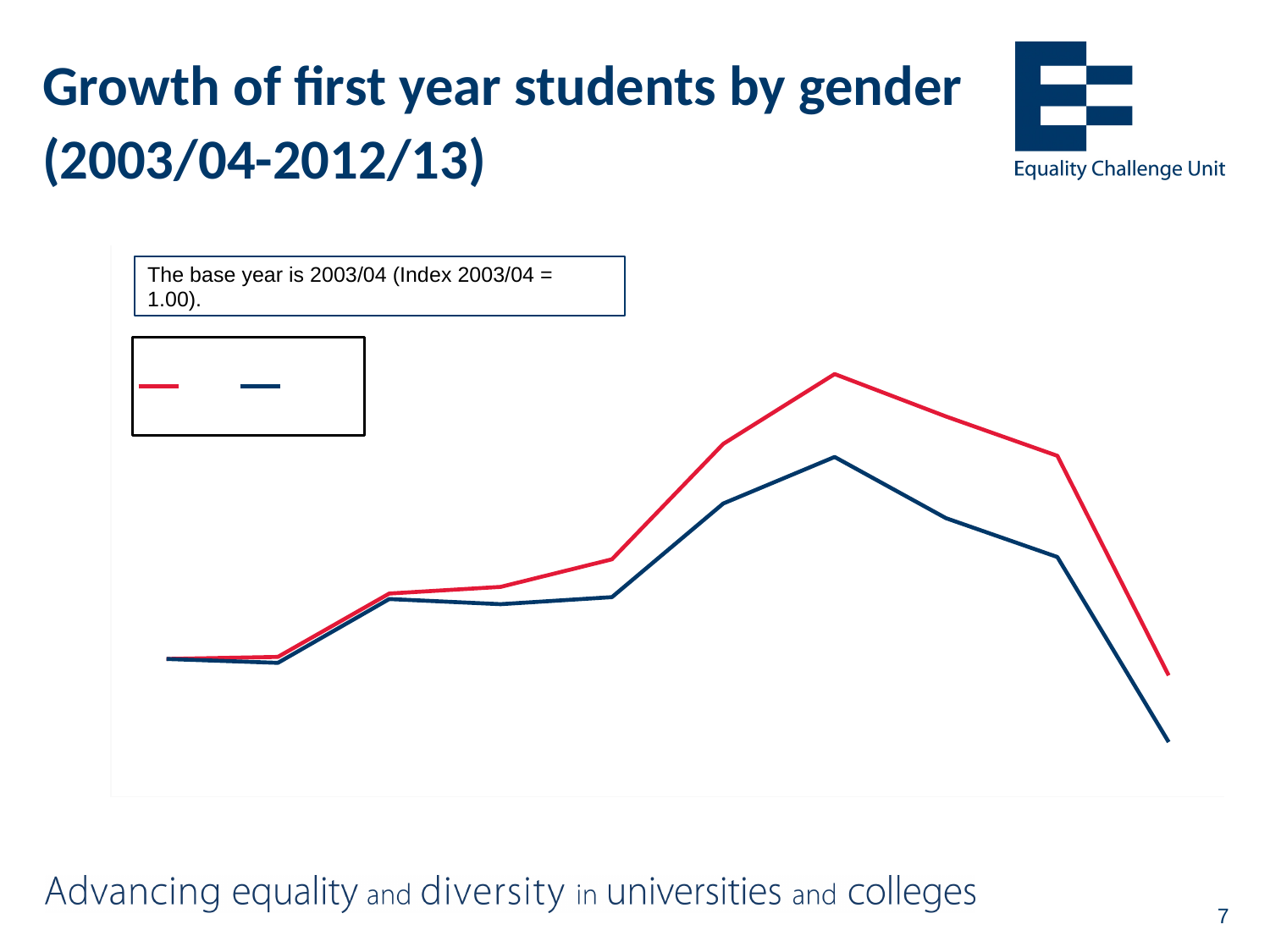
How many series does the legend list? 2 At which data point (counting from the left) does the dark blue line reach its lowest value? The last (tenth) What is the title of the chart on the slide? Growth of first year students by gender (2003/04-2012/13) Which line reaches the higher peak, the red line or the dark blue line? The red line What kind of chart is shown on the slide? Line chart At which data point (counting from the left) does the red line reach its highest value? The seventh How many data points does each line on the chart have? 10 At the last data point, which line is higher, the red line or the dark blue line? The red line According to the note on the slide, what is the base year of the index? 2003/04 Do the lines rise or fall between the seventh data point and the last data point? Fall Does the dark blue line end higher or lower than it starts? Lower Do the lines rise or fall between the first data point and the seventh data point? Rise